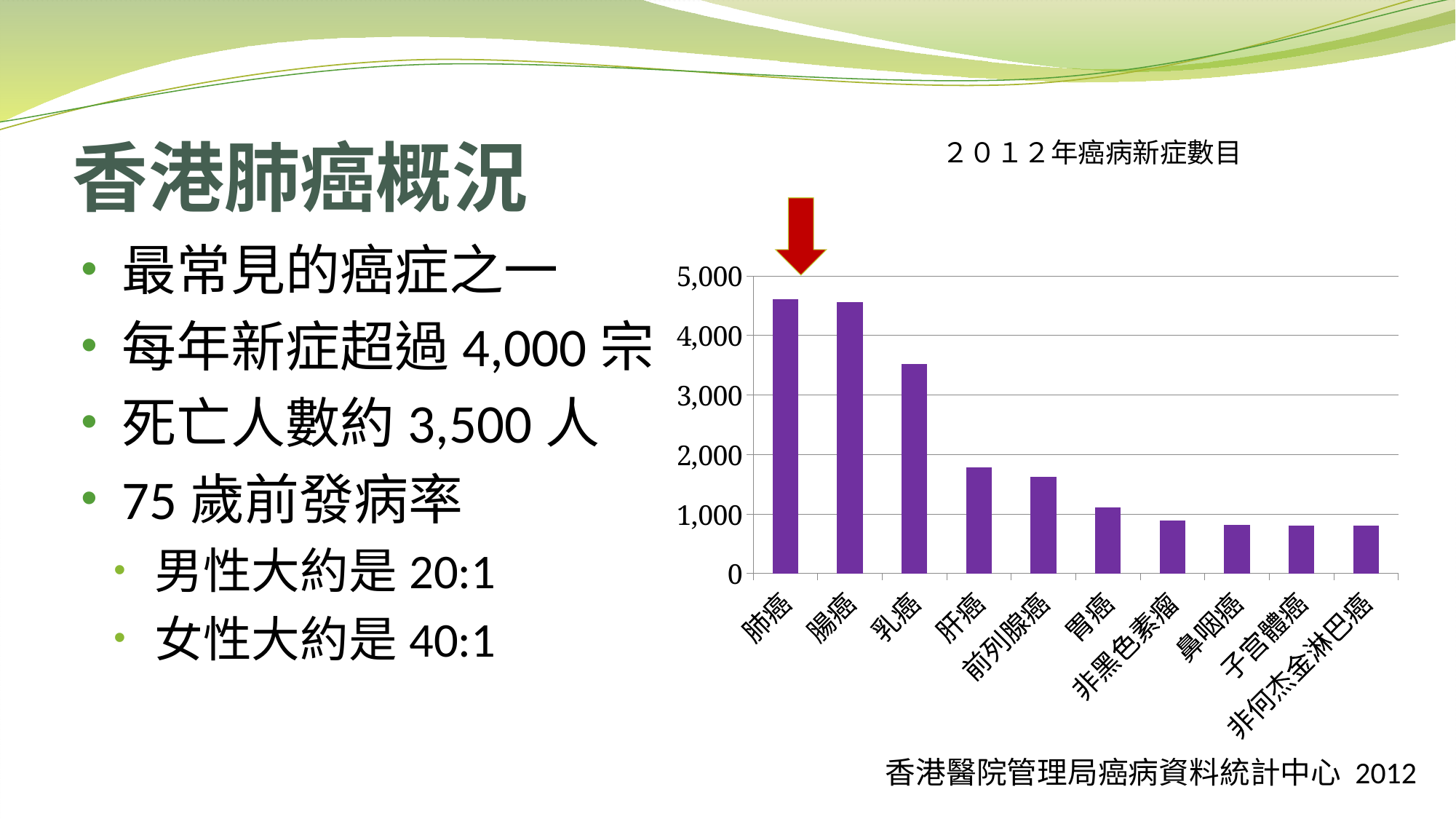
Which has a higher value, 乳癌 or 肝癌? 乳癌 Is the value for 肝癌 greater or less than 2,000? less Is the value for 肺癌 greater or less than 4,000? greater Is the value for 乳癌 greater or less than 3,000? greater Do the bar values rise or fall from left to right along the x axis? fall Which category does the red arrow above the chart point to? 肺癌 What kind of chart is shown on the slide? bar chart What is the title of the chart? ２０１２年癌病新症數目 Which has a higher value, 肝癌 or 胃癌? 肝癌 How many cancer types are shown on the x axis of the chart? 10